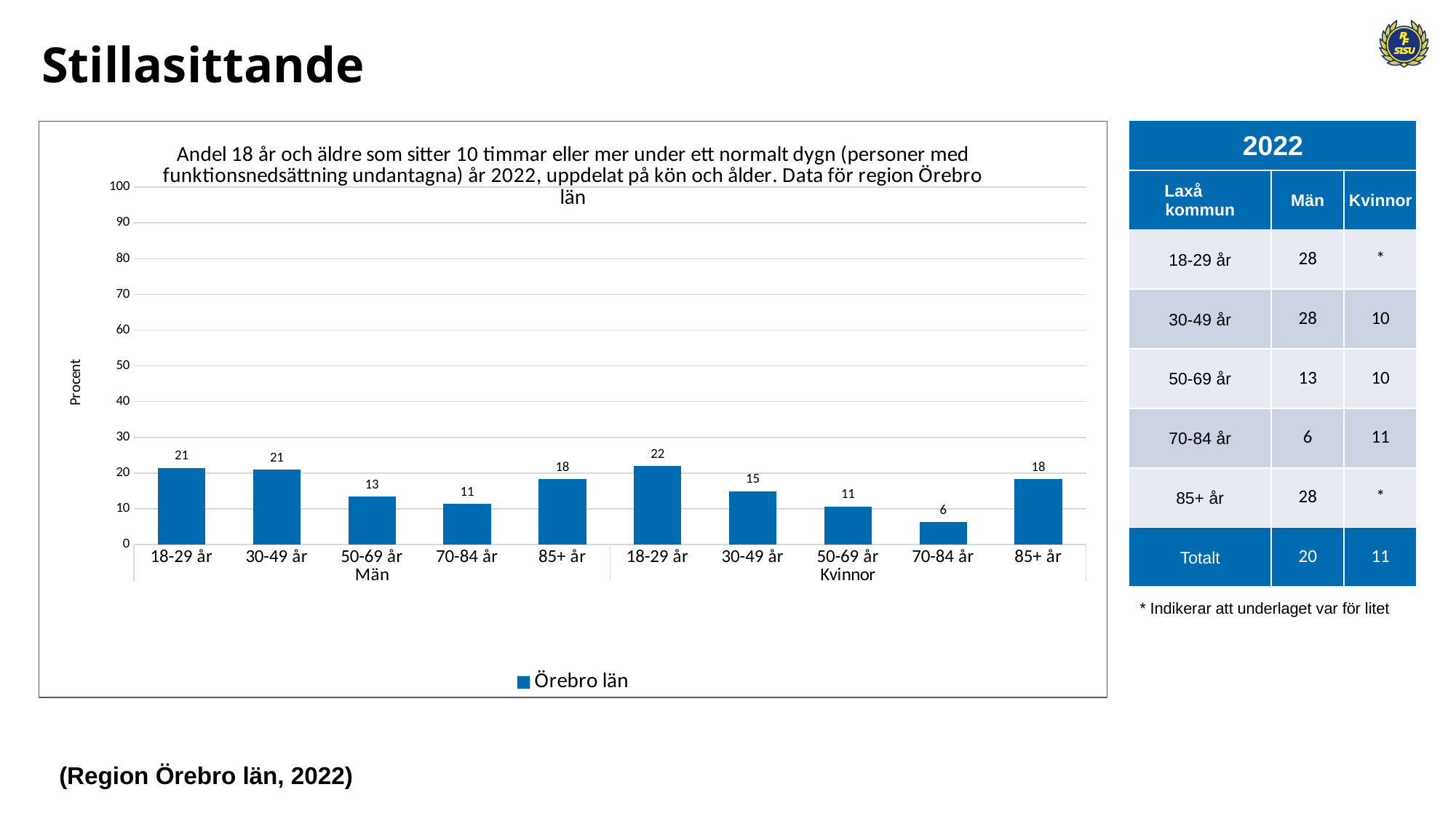
How many bars are plotted in the chart? 10 What is the value for men aged 18-29 år in the chart? 21 What is the difference between the values for men aged 18-29 år and men aged 50-69 år? 8 Which bar in the chart has the lowest value? Kvinnor 70-84 år Is the value for women aged 18-29 år greater or less than 30? less What is the value for women aged 30-49 år in the chart? 15 Which is larger: the value for men aged 85+ år or women aged 50-69 år? Men aged 85+ år What kind of chart is shown on the slide? Bar chart How many series does the chart legend list? 1 What is the label of the y axis in the chart? Procent What is the value for women aged 70-84 år in the chart? 6 Which bar in the chart has the highest value? Kvinnor 18-29 år